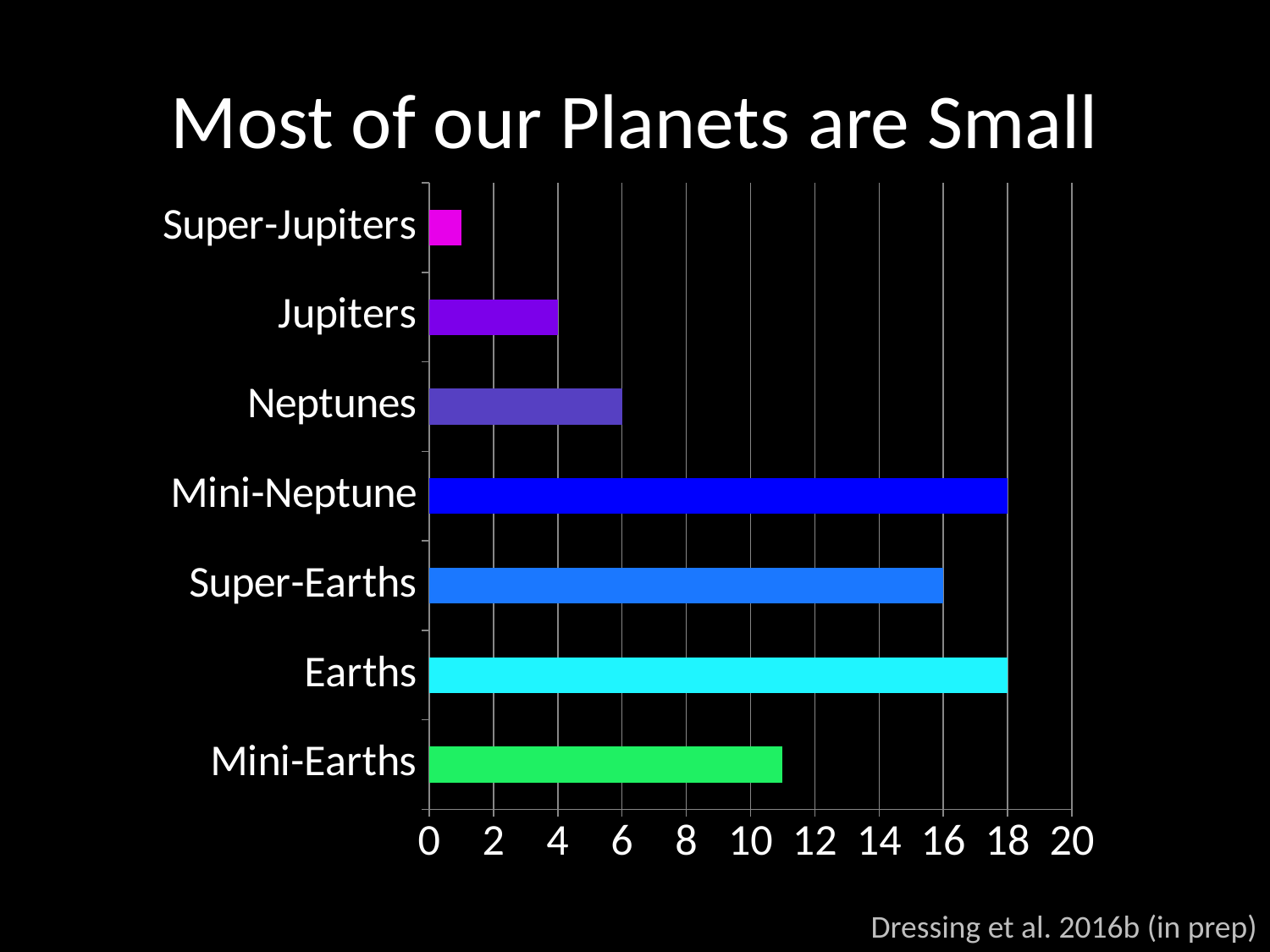
Is the value for Mini-Earths greater or less than 10? greater What is the value for Super-Earths? 16 What is the title of the slide? Most of our Planets are Small What is the value for Neptunes? 6 Which is larger, the value for Super-Earths or the value for Jupiters? Super-Earths What kind of chart is shown on the slide? bar chart What is the difference between the values for Super-Earths and Neptunes? 10 Which category has the lowest value in the chart? Super-Jupiters What is the value for Jupiters? 4 What is the value for Mini-Neptune? 18 Is the value for Super-Jupiters greater or less than 2? less How many planet categories are plotted in the chart? 7